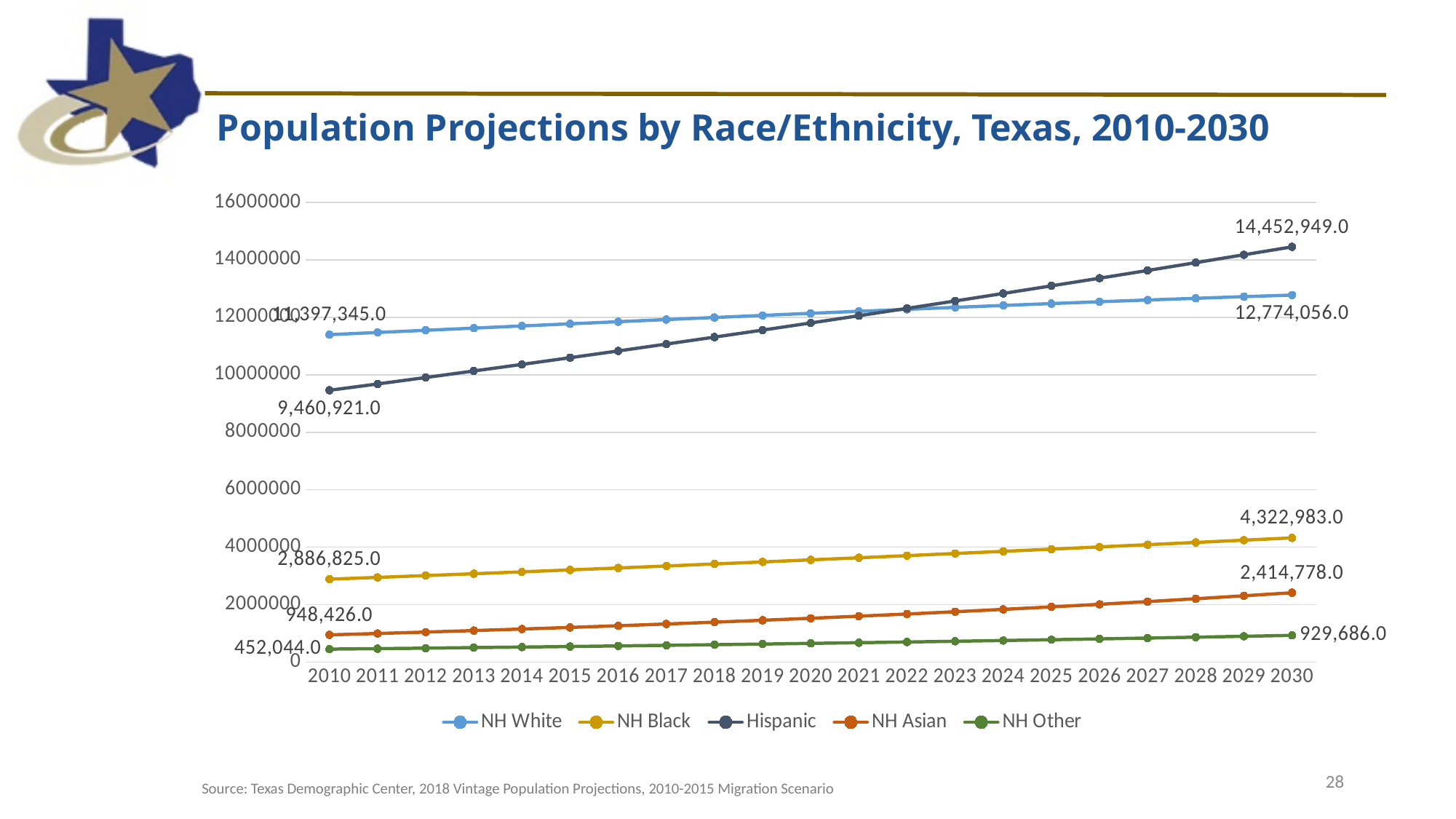
How many series does the legend list? 5 How many years are shown on the x axis? 21 What is the projected NH Black population in 2030? 4,322,983.0 What kind of chart is shown on the slide? line chart What is the projected NH Other population in 2030? 929,686.0 What is the projected Hispanic population in 2030? 14,452,949.0 Which group has the lowest projected population in 2030? NH Other What is the NH Asian population value shown for 2010? 948,426.0 By how much does the Hispanic population increase from 2010 to 2030? 4,992,028.0 In 2010, which is larger: the NH White population or the Hispanic population? NH White What is the Hispanic population value shown for 2010? 9,460,921.0 Which group has the highest projected population in 2030? Hispanic